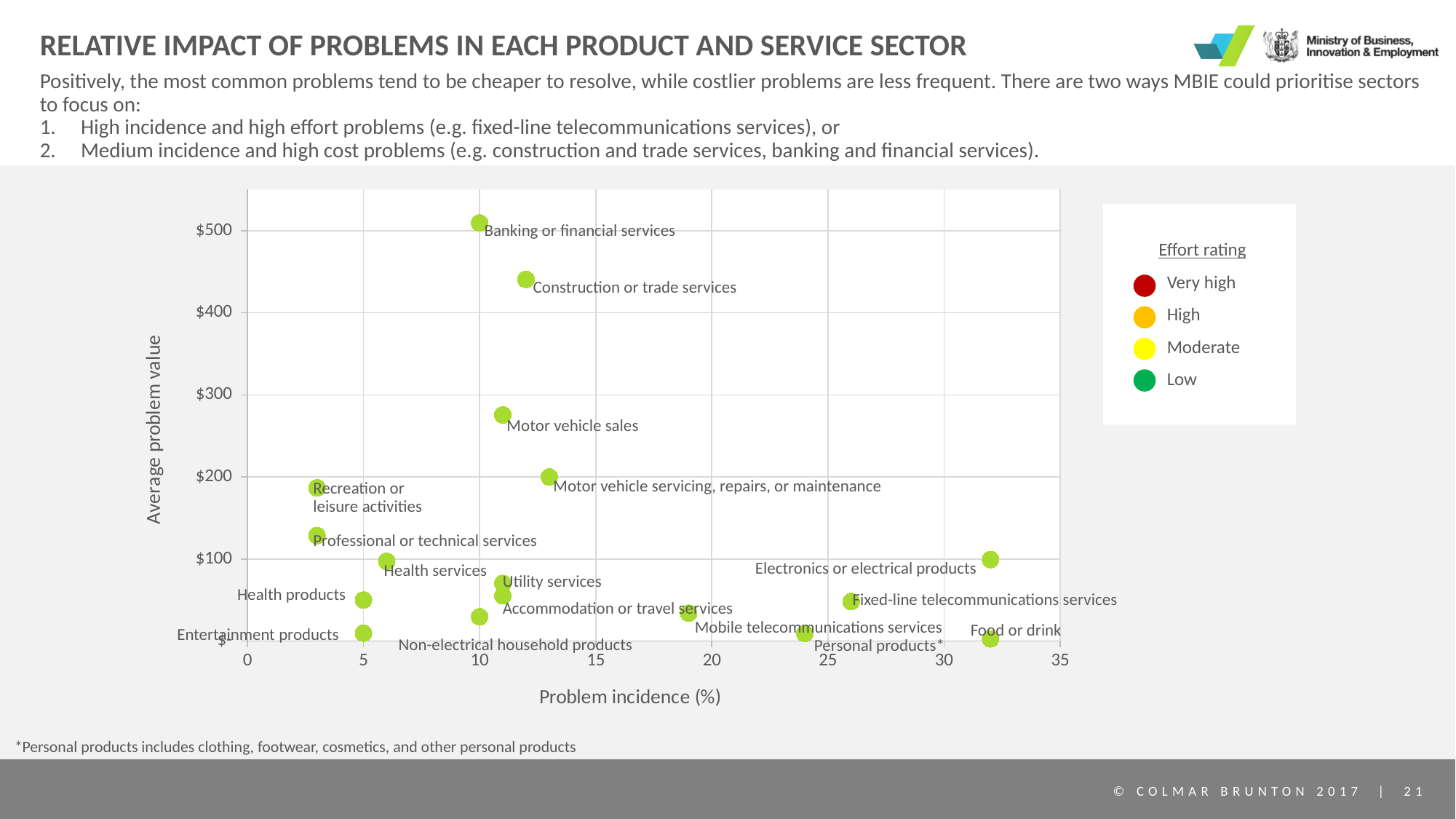
Which has a higher average problem value, Banking or financial services or Construction or trade services? Banking or financial services Is the problem incidence for Recreation or leisure activities greater or less than 5%? less Is the problem incidence for Electronics or electrical products greater or less than 30%? greater Which sector has the highest average problem value? Banking or financial services Is the average problem value for Construction or trade services greater or less than $400? greater What kind of chart is shown on the slide? Scatter chart How many sectors are plotted on the chart? 17 Which has a higher problem incidence, Electronics or electrical products or Fixed-line telecommunications services? Electronics or electrical products What is the title of the horizontal axis? Problem incidence (%) How many effort rating levels does the legend list? 4